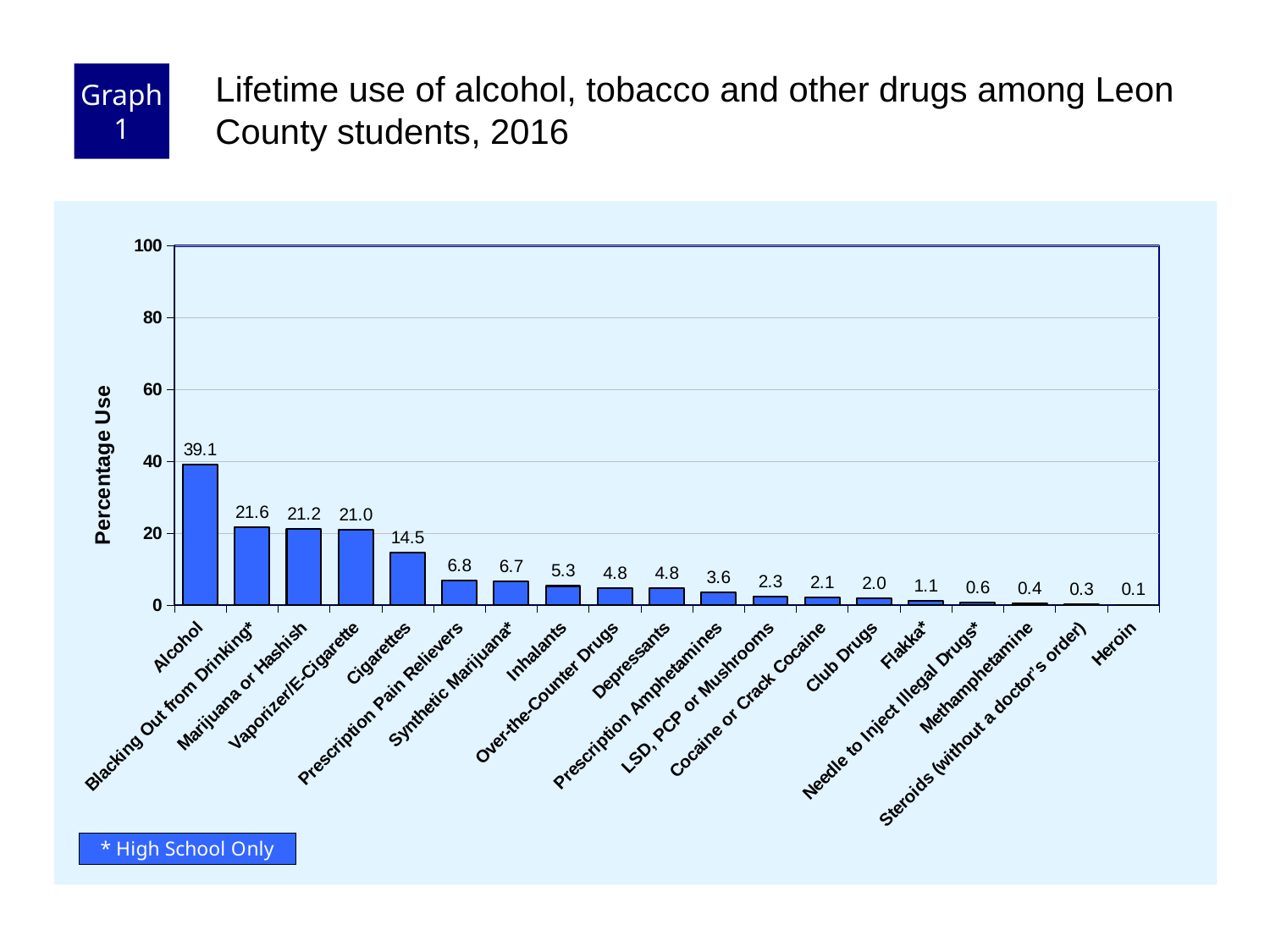
What is the difference in percentage use between Alcohol and Blacking Out from Drinking*? 17.5 What is the label of the y axis? Percentage Use How many categories are shown on the x axis? 19 What is the percentage use for Flakka*? 1.1 Is the value for Alcohol greater or less than 20? greater What is the percentage use for Alcohol? 39.1 Which has a higher percentage use, Cigarettes or Prescription Pain Relievers? Cigarettes Which category has the lowest percentage use? Heroin What kind of chart is shown on the slide? Bar chart What is the percentage use for Inhalants? 5.3 What is the percentage use for Cigarettes? 14.5 Which category has the highest percentage use? Alcohol